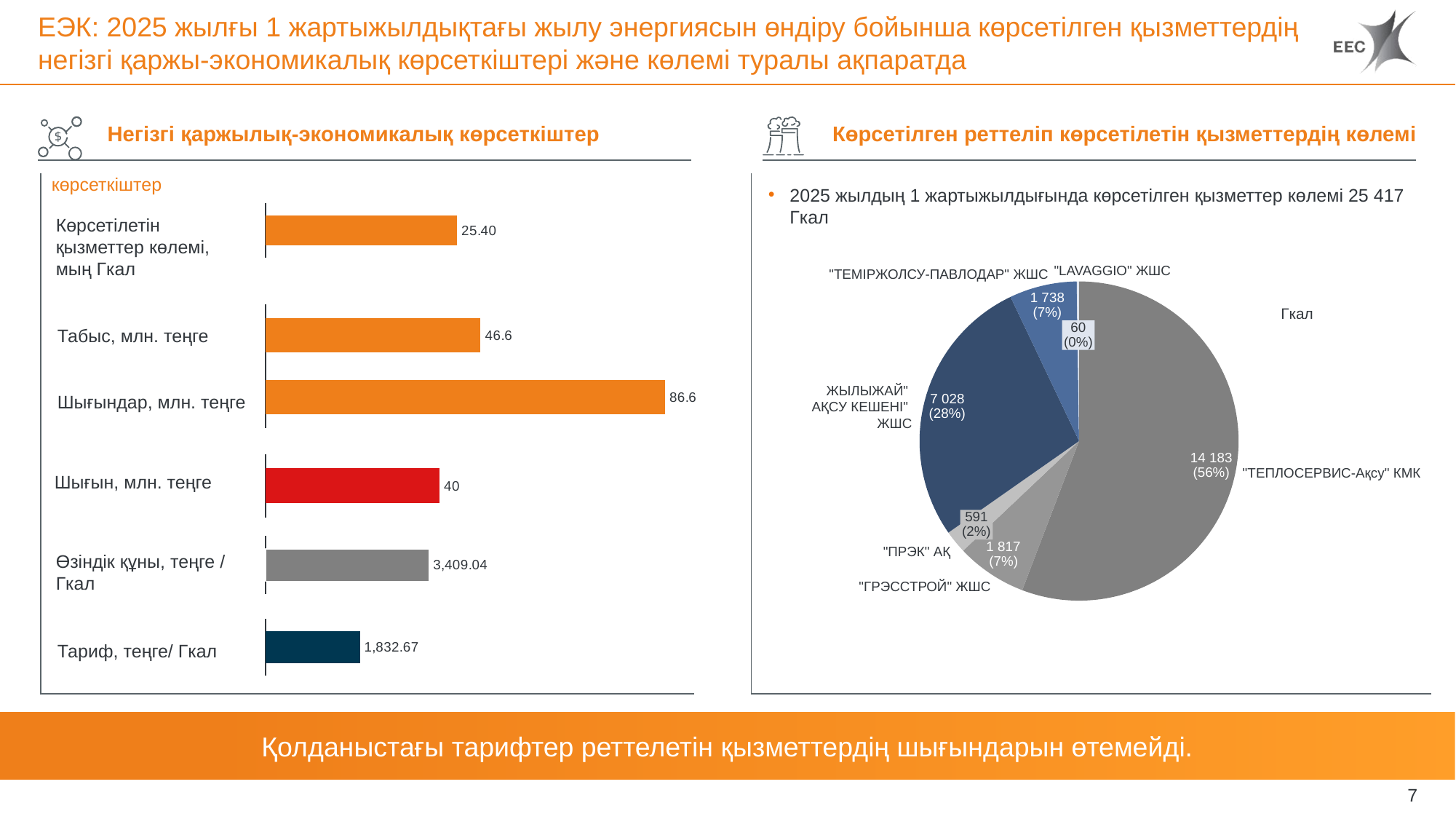
In the left bar chart, what is the value for Табыс, млн. теңге? 46.6 In the pie chart on the right, which company has the smallest slice? "LAVAGGIO" ЖШС In the pie chart on the right, what is the difference between "ТЕПЛОСЕРВИС-Ақсу" КМК and "ЖЫЛЫЖАЙ АҚСУ КЕШЕНІ" ЖШС? 7 155 What kind of chart is the chart on the left side of the slide? Bar chart How many slices does the pie chart on the right have? 6 In the pie chart on the right, what is the value for "ТЕПЛОСЕРВИС-Ақсу" КМК? 14 183 In the left bar chart, what is the value for Өзіндік құны, теңге / Гкал? 3,409.04 In the left bar chart, what is the value for Тариф, теңге/ Гкал? 1,832.67 In the left bar chart, what is the difference between Шығындар, млн. теңге and Табыс, млн. теңге? 40 In the pie chart on the right, which company has the largest slice? "ТЕПЛОСЕРВИС-Ақсу" КМК In the pie chart on the right, what share does "ЖЫЛЫЖАЙ АҚСУ КЕШЕНІ" ЖШС have? 28% How many categories does the left bar chart show? 6